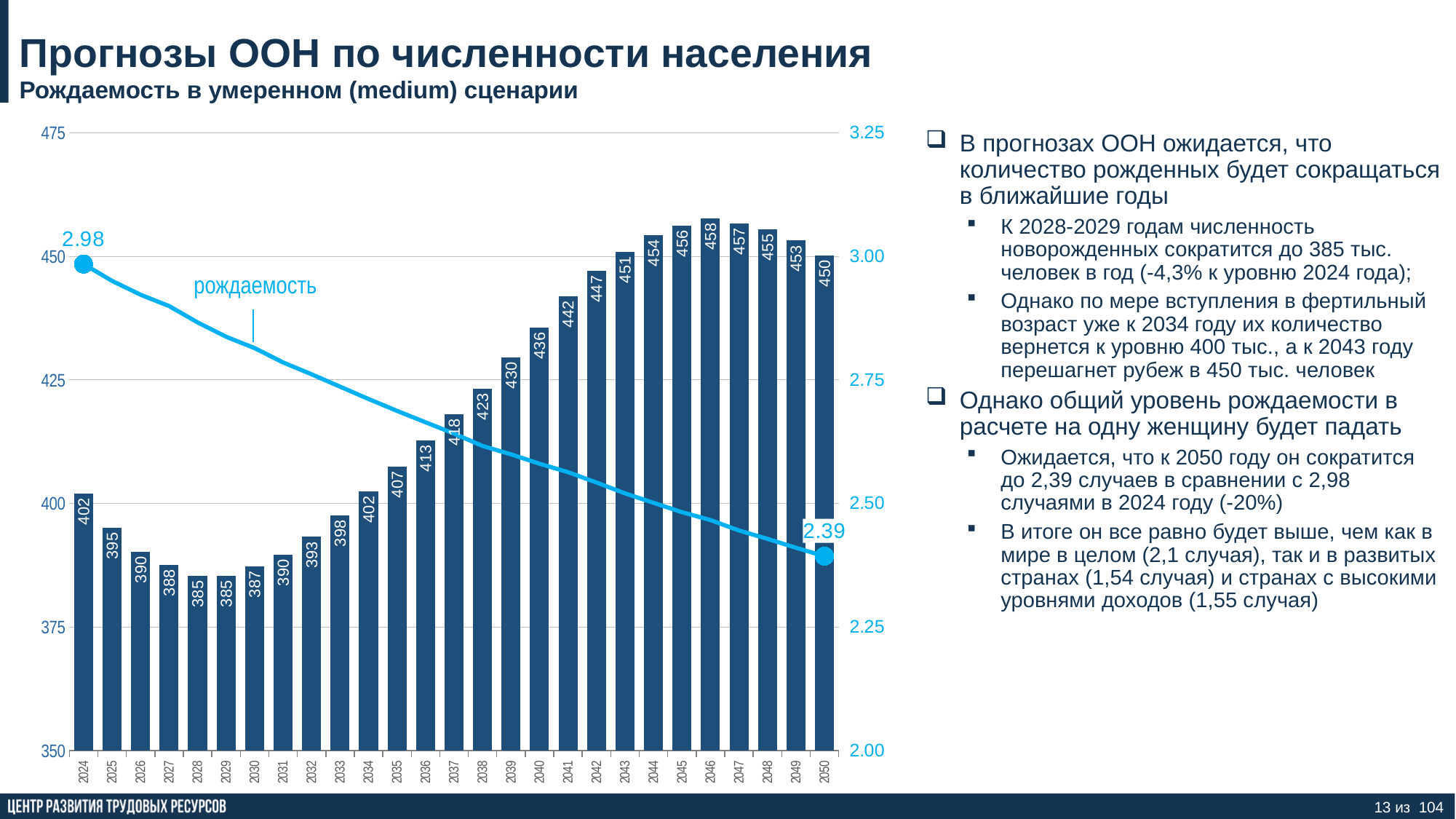
What is the value of the bar for 2040? 436 What is the value of the bar for 2024? 402 What is the difference between the bar values for 2024 and 2050? 48 Which is larger, the bar for 2035 or the bar for 2033? 2035 Does the line labelled 'рождаемость' rise or fall from 2024 to 2050? fall Which year has the highest bar? 2046 How many years are shown on the x axis? 27 What is the value of the bar for 2050? 450 What is the value of the line labelled 'рождаемость' at 2024? 2.98 What is the difference between the bar values for 2046 and 2028? 73 What is the value of the line labelled 'рождаемость' at 2050? 2.39 What is the label shown on the line series in the chart? рождаемость